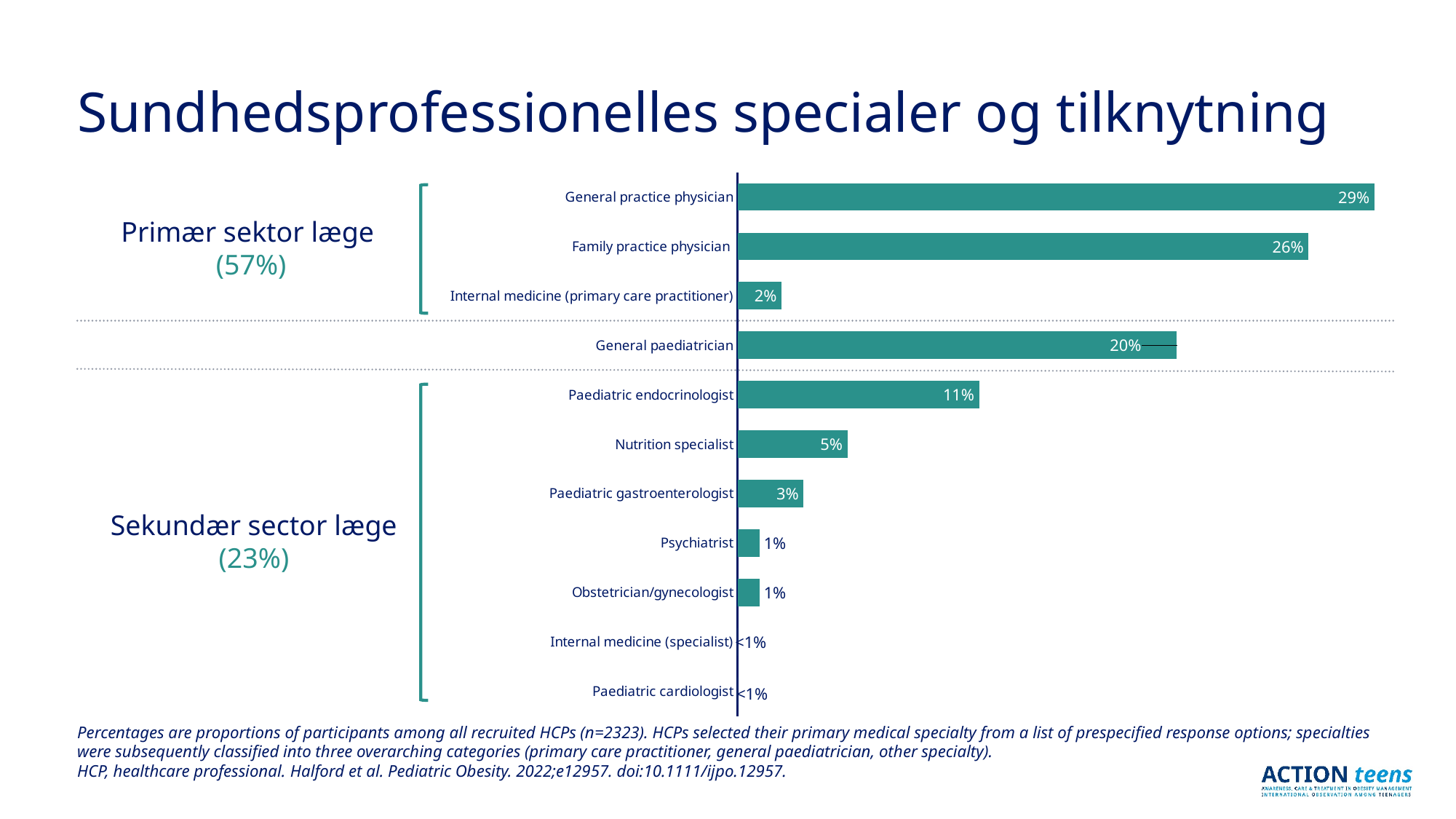
What percentage is shown for General practice physician? 29% What percentage is given for the Primær sektor læge group? 57% What percentage is given for the Sekundær sector læge group? 23% What kind of chart is shown on the slide? Bar chart Which specialty has the highest percentage? General practice physician Which is larger, the percentage for Nutrition specialist or for Paediatric gastroenterologist? Nutrition specialist What percentage is shown for Paediatric endocrinologist? 11% What value is shown for Paediatric cardiologist? <1% How many specialty categories are plotted in the chart? 11 What percentage is shown for General paediatrician? 20% What is the difference between the percentages for General practice physician and Family practice physician? 3% What is the difference between the percentages for General paediatrician and Paediatric endocrinologist? 9%